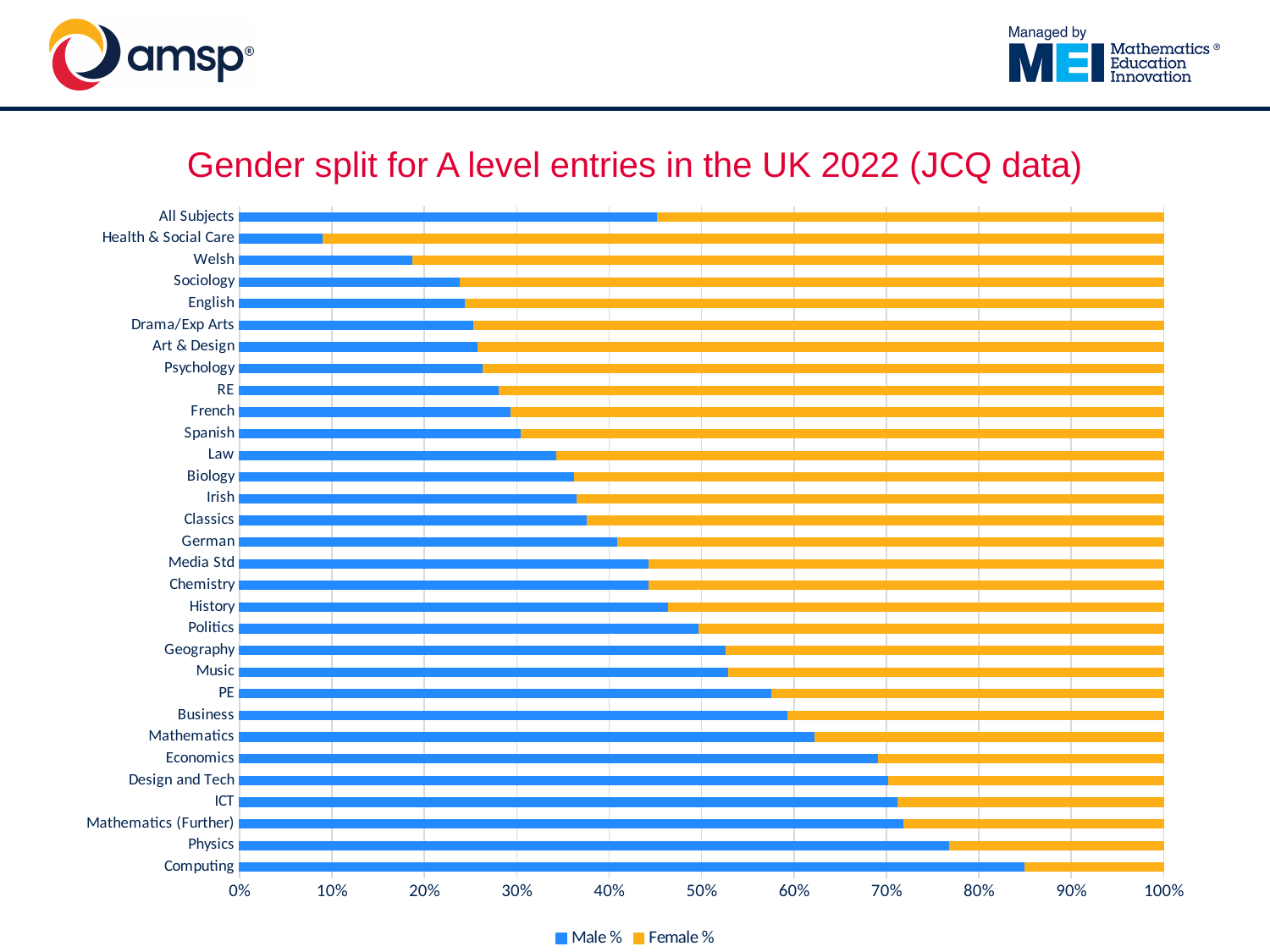
Which has the larger Male % share, Physics or Mathematics? Physics Which subject has the highest Male % share? Computing Is the Male % value for Mathematics greater or less than 60%? greater How many series does the legend list? 2 Is the Male % value for All Subjects greater or less than 50%? less What is the title of the chart? Gender split for A level entries in the UK 2022 (JCQ data) Is the Male % value for Computing greater or less than 80%? greater Which subject has the lowest Male % share? Health & Social Care How many subject categories are plotted on the chart? 31 Which has the larger Female % share, Biology or Chemistry? Biology What kind of chart is shown on the slide? Stacked bar chart